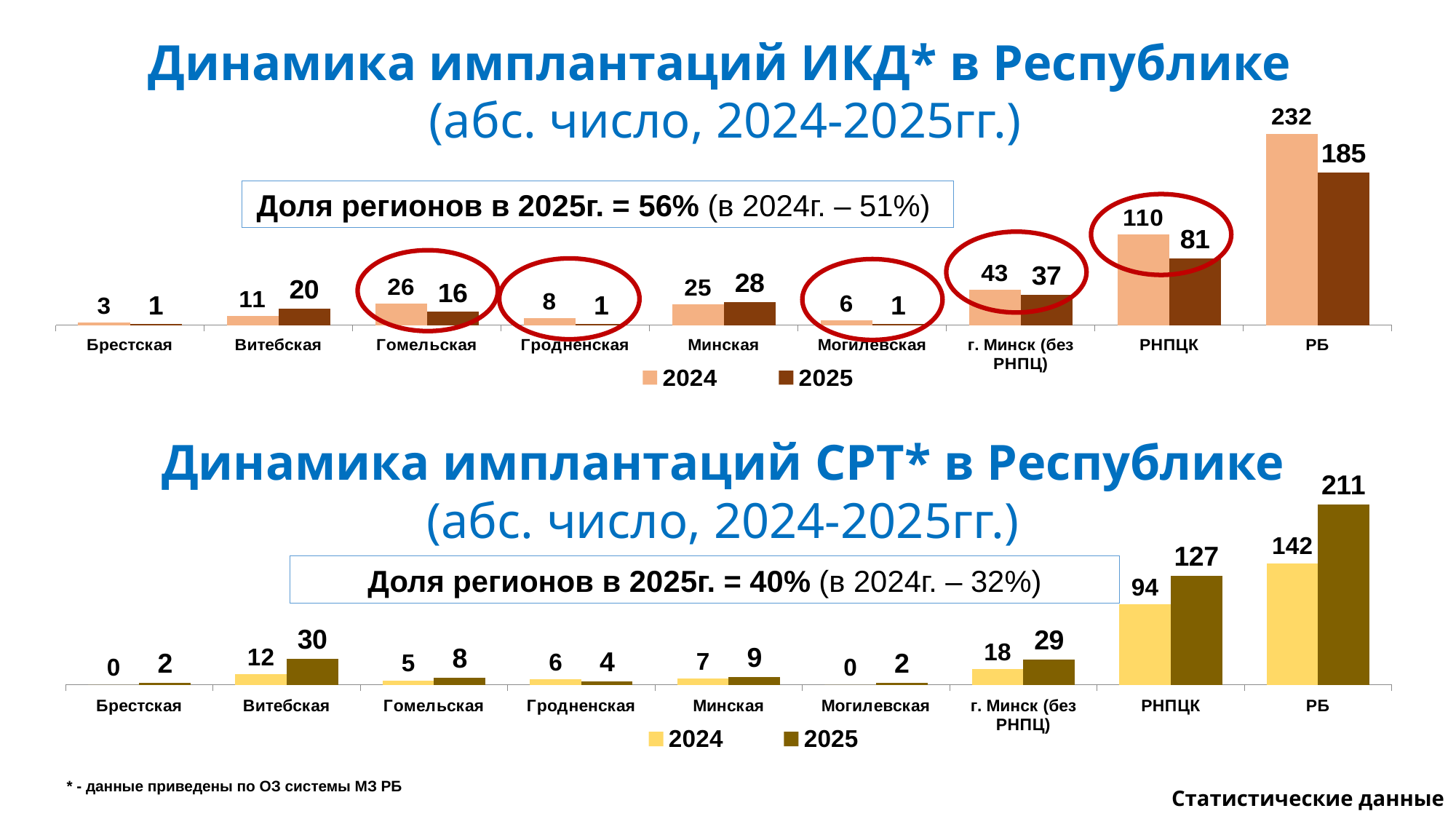
In the bottom chart (Динамика имплантаций СРТ), how many categories are shown on the x axis? 9 In the top chart (Динамика имплантаций ИКД), which category has the highest 2025 value? РБ What kind of chart is the bottom chart (Динамика имплантаций СРТ)? Bar chart In the top chart (Динамика имплантаций ИКД), what is the 2024 value for РНПЦК? 110 In the top chart (Динамика имплантаций ИКД), what is the 2025 value for Минская? 28 In the top chart (Динамика имплантаций ИКД), which is larger for Гомельская: the 2024 value or the 2025 value? 2024 In the top chart (Динамика имплантаций ИКД), how many series does the legend list? 2 In the bottom chart (Динамика имплантаций СРТ), what is the 2024 value for г. Минск (без РНПЦ)? 18 In the top chart (Динамика имплантаций ИКД), what is the difference between the 2024 and 2025 values for РБ? 47 In the bottom chart (Динамика имплантаций СРТ), which category has the lowest 2025 value? Брестская and Могилевская (both 2) In the bottom chart (Динамика имплантаций СРТ), what is the difference between the 2025 and 2024 values for РНПЦК? 33 In the bottom chart (Динамика имплантаций СРТ), what is the 2025 value for Витебская? 30